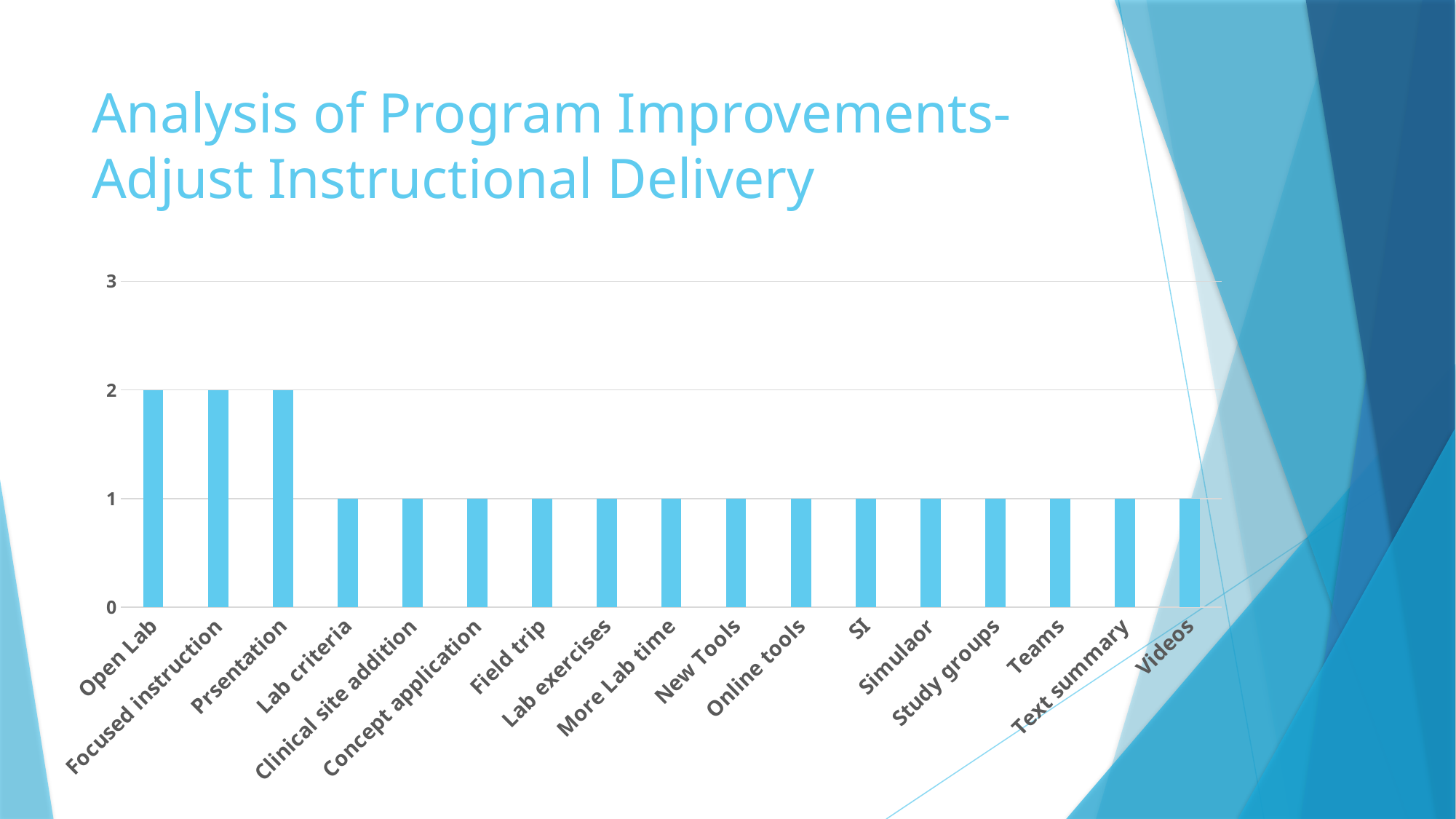
What is the value for Lab criteria? 1 Which is larger, the value for Prsentation or the value for Field trip? Prsentation What is the value for Open Lab? 2 Is the value for More Lab time greater or less than 2? less What kind of chart is shown on the slide? bar chart What is the difference between the value for Open Lab and the value for Teams? 1 What is the value for Study groups? 1 What is the highest value shown on the vertical axis? 3 How many categories have a value of 2? 3 What is the value for Focused instruction? 2 How many categories are plotted on the chart? 17 What is the value for Videos? 1